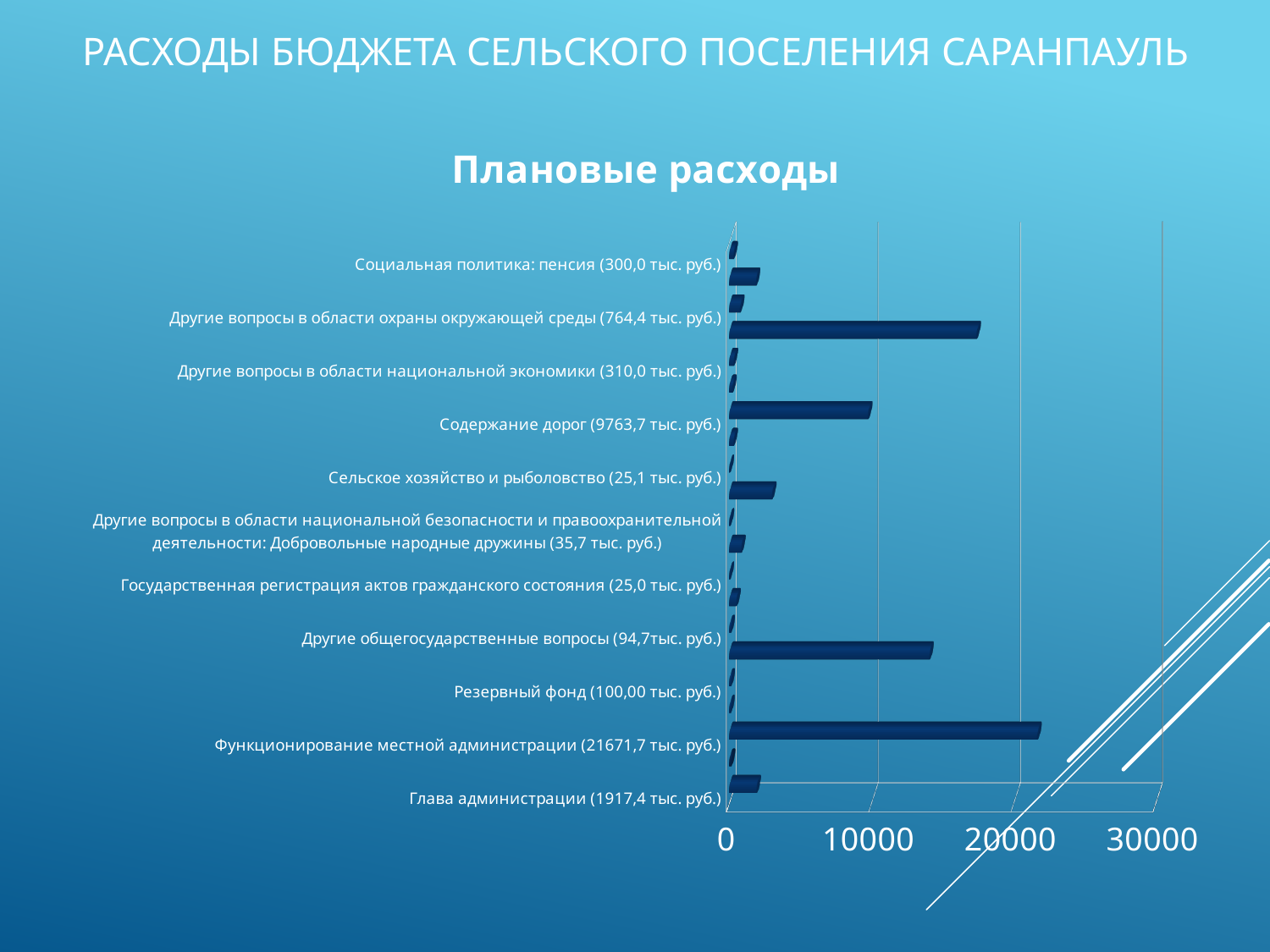
Which category has the largest planned expenditure according to the labels? Функционирование местной администрации What is the highest value shown on the horizontal axis of the chart? 30000 What is the title of the chart? Плановые расходы What is the difference between the labelled values for Функционирование местной администрации and Содержание дорог? 11908,0 тыс. руб. Which category has the smallest planned expenditure according to the labels? Государственная регистрация актов гражданского состояния Which is larger according to the labels: Содержание дорог or Глава администрации? Содержание дорог What type of chart is shown on the slide? Bar chart Is the longest bar on the chart greater or less than 20000? greater How many category labels are listed on the chart's vertical axis? 11 According to the category label, what is the planned expenditure for Глава администрации? 1917,4 тыс. руб. According to the category label, what is the planned expenditure for Функционирование местной администрации? 21671,7 тыс. руб. According to the category label, what is the planned expenditure for Содержание дорог? 9763,7 тыс. руб.